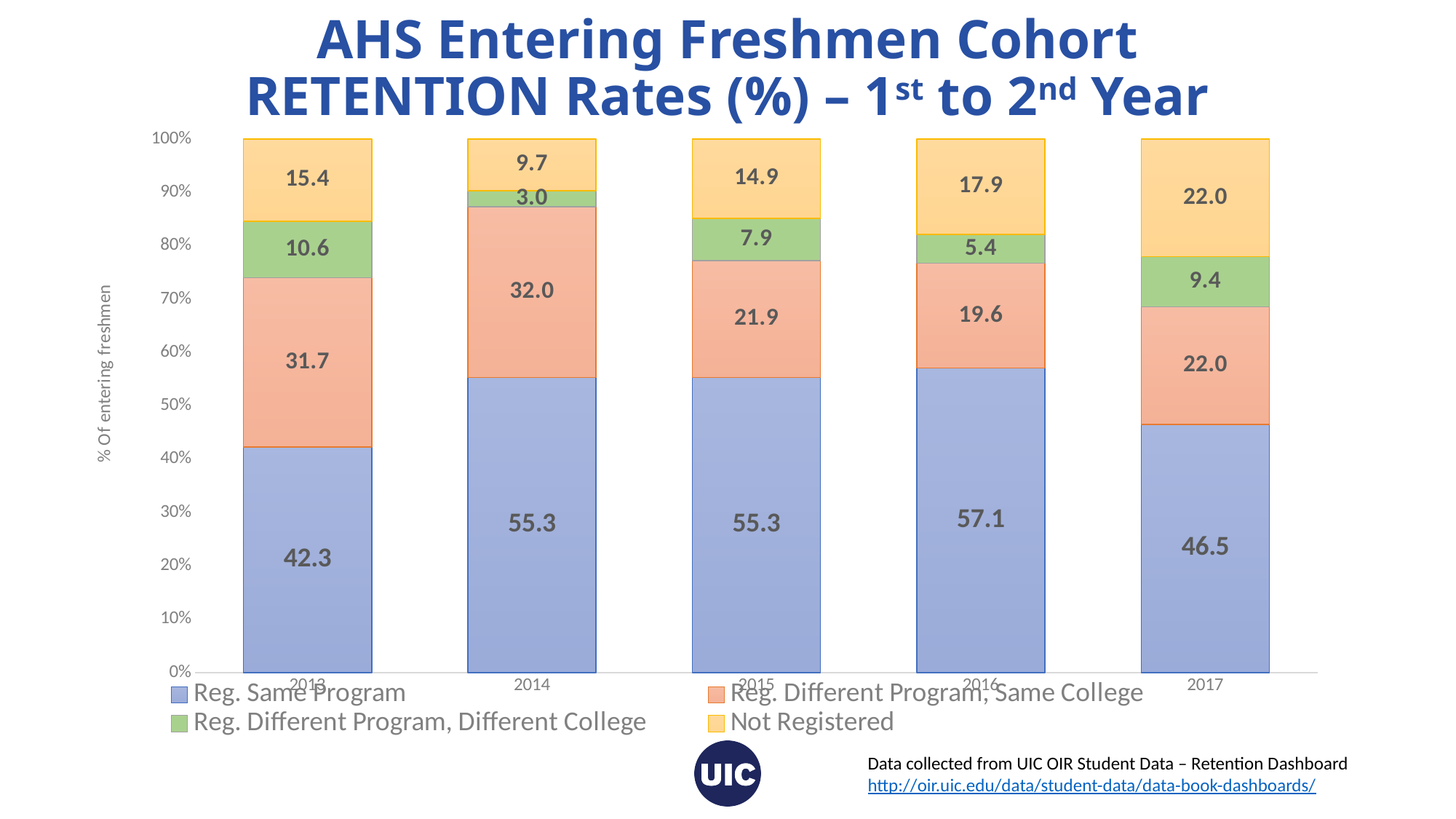
What is the Not Registered value for 2014? 9.7 Which year has the highest value for Reg. Same Program? 2016 Which year has the larger value for Reg. Different Program, Same College, 2014 or 2017? 2014 What is the value for Reg. Different Program, Same College in 2015? 21.9 Which year has the highest Not Registered value? 2017 What is the difference between the Reg. Same Program values for 2016 and 2013? 14.8 How many series does the legend list? 4 What is the value for Reg. Same Program in 2016? 57.1 How many years are shown on the x axis? 5 Which year has the lowest value for Reg. Different Program, Different College? 2014 Does the Not Registered value rise or fall from 2014 to 2017? Rises What kind of chart is shown on the slide? Stacked bar chart